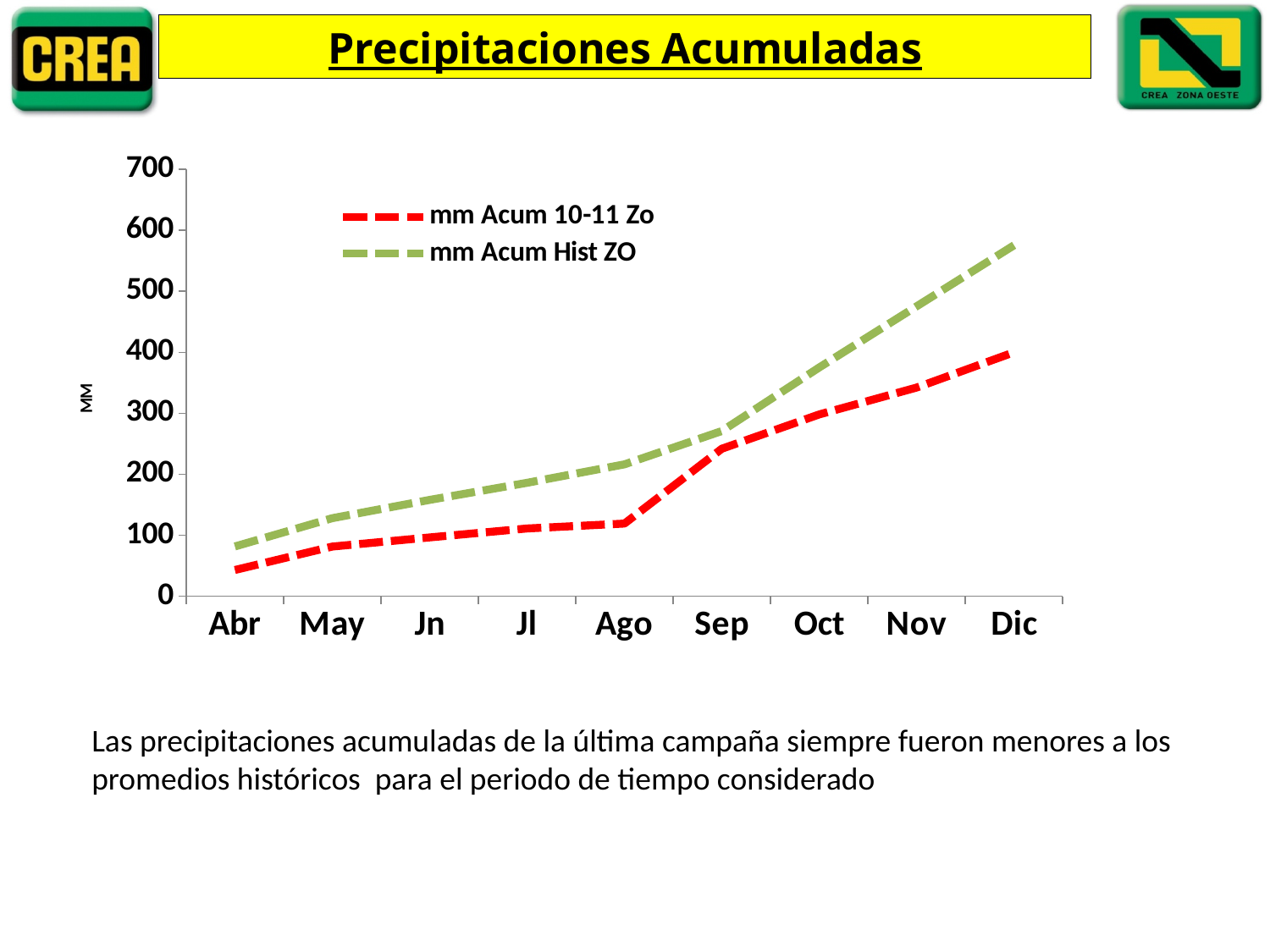
Is the value for mm Acum Hist ZO in Dic greater or less than 500? greater Do the values of mm Acum Hist ZO rise or fall from Abr to Dic? rise How many series does the legend list? 2 How many months are shown on the x axis? 9 What kind of chart is shown on the slide? line chart Is the value for mm Acum Hist ZO in Oct greater or less than 300? greater What is the title of the slide's chart? Precipitaciones Acumuladas What label is shown on the vertical axis? MM In Dic, which series has the higher value, mm Acum 10-11 Zo or mm Acum Hist ZO? mm Acum Hist ZO Is the value for mm Acum 10-11 Zo in Abr greater or less than 100? less In which month does mm Acum 10-11 Zo reach its highest value? Dic